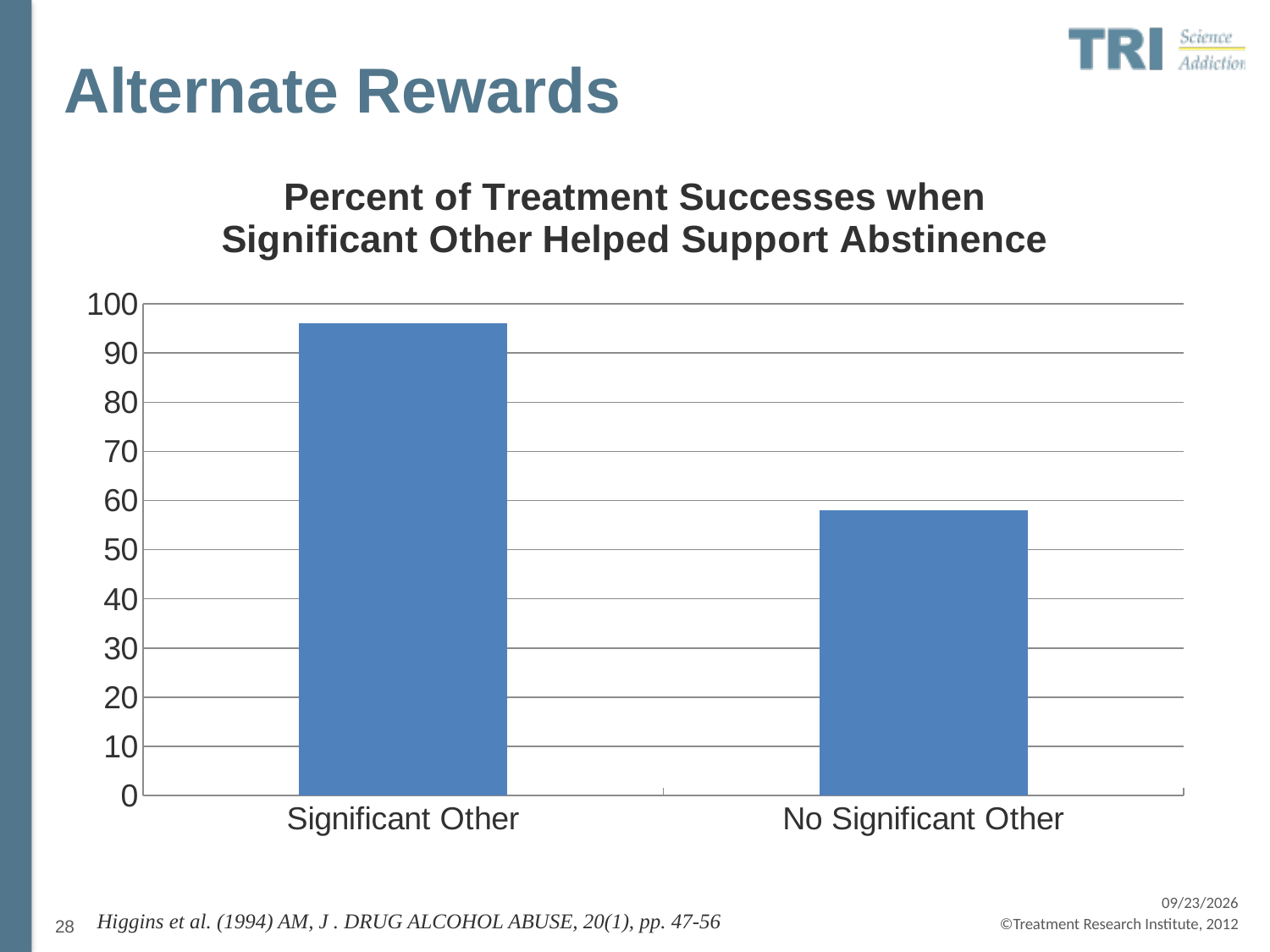
Which category has the lowest value in the chart? No Significant Other What is the maximum value shown on the y axis of the chart? 100 Which category has the highest value in the chart? Significant Other How many categories are shown on the x axis of the chart? 2 Which is larger, the value for Significant Other or the value for No Significant Other? Significant Other Is the value for No Significant Other greater or less than 50? greater What type of chart is shown on the slide? bar chart Is the value for Significant Other greater or less than 90? greater What is the title of the chart? Percent of Treatment Successes when Significant Other Helped Support Abstinence Do the values rise or fall from left to right across the x axis? fall